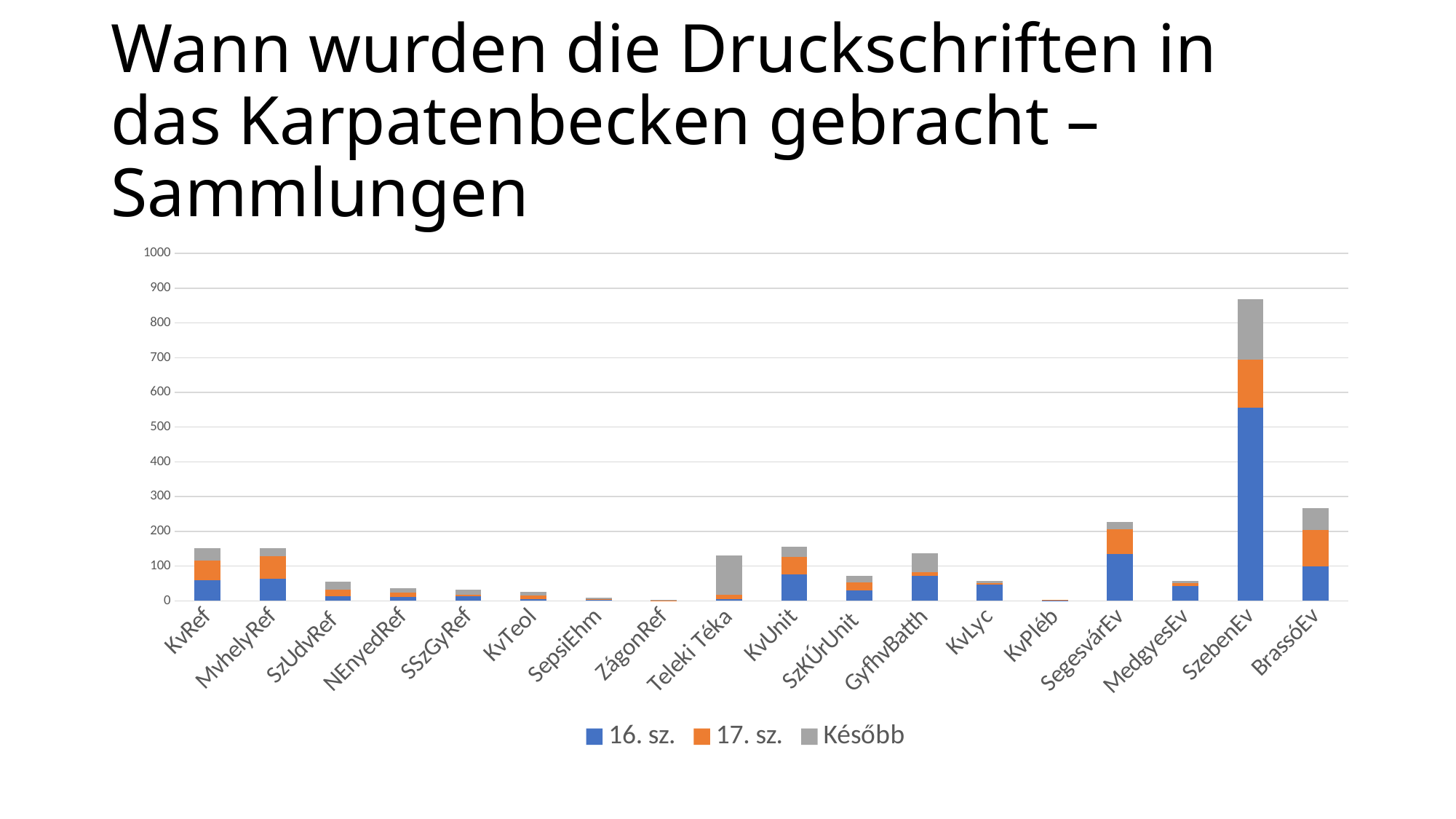
Is the total value for SzebenEv greater or less than 800? greater What is the third series listed in the legend? Később Is the total value for BrassóEv greater or less than 200? greater What kind of chart is shown on the slide? stacked bar chart Which has the larger total bar, SegesvárEv or KvUnit? SegesvárEv Is the 16. sz. value for SzebenEv greater or less than 500? greater Which series is shown in blue in the legend? 16. sz. Which has the larger total bar, Teleki Téka or KvTeol? Teleki Téka Which category has the highest total bar? SzebenEv How many categories are shown on the x axis of the chart? 18 How many series does the legend list? 3